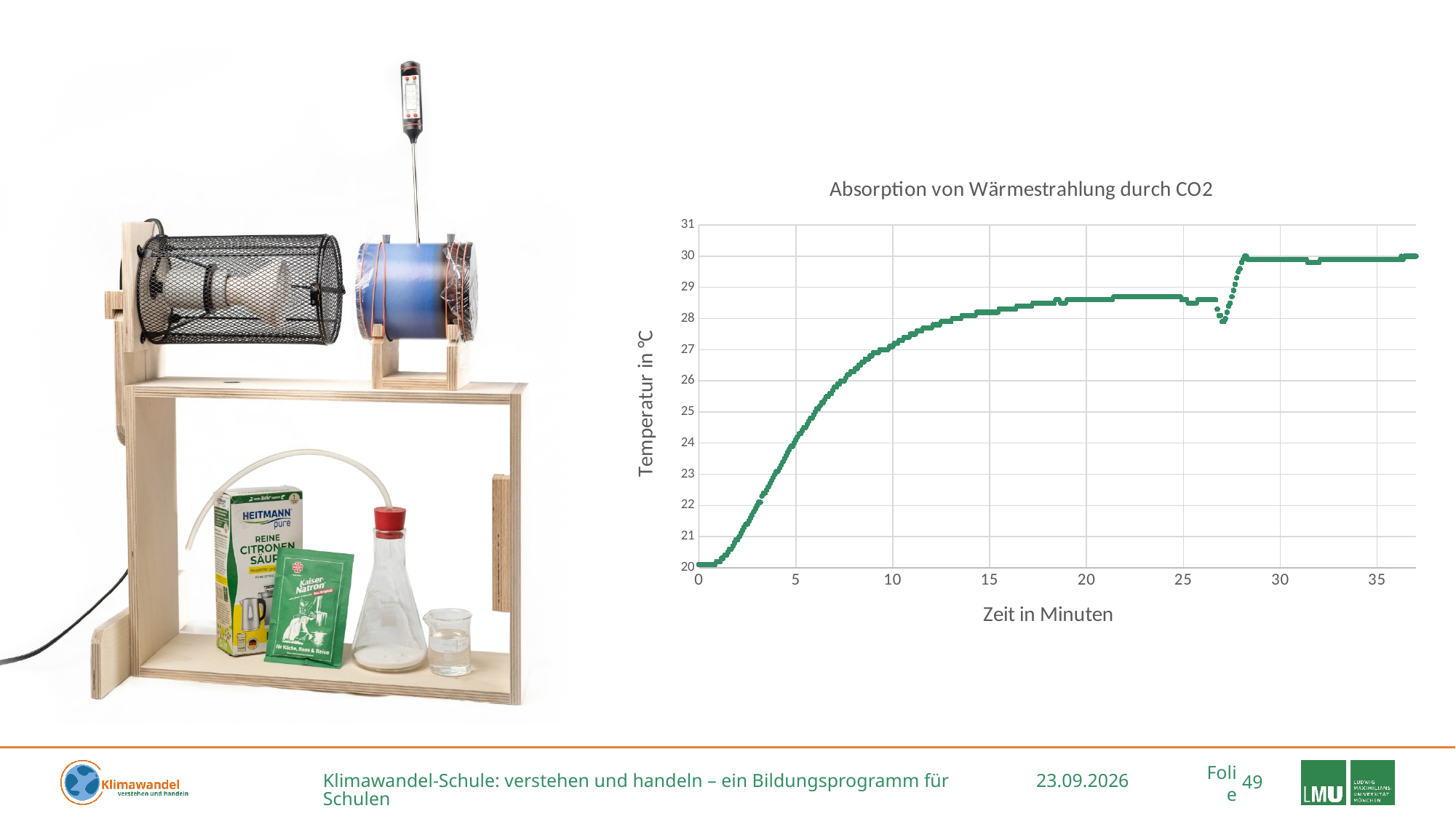
Is the temperature at 20 minutes greater or less than 28? greater Is the temperature at 2 minutes greater or less than 22? less Is the temperature at 35 minutes greater or less than 29? greater What is the label of the y axis of the chart? Temperatur in °C Does the temperature generally rise or fall over the first 20 minutes? rise What kind of chart is shown on the slide? scatter chart What is the title of the chart? Absorption von Wärmestrahlung durch CO2 Is the temperature higher at 30 minutes or at 10 minutes? 30 minutes